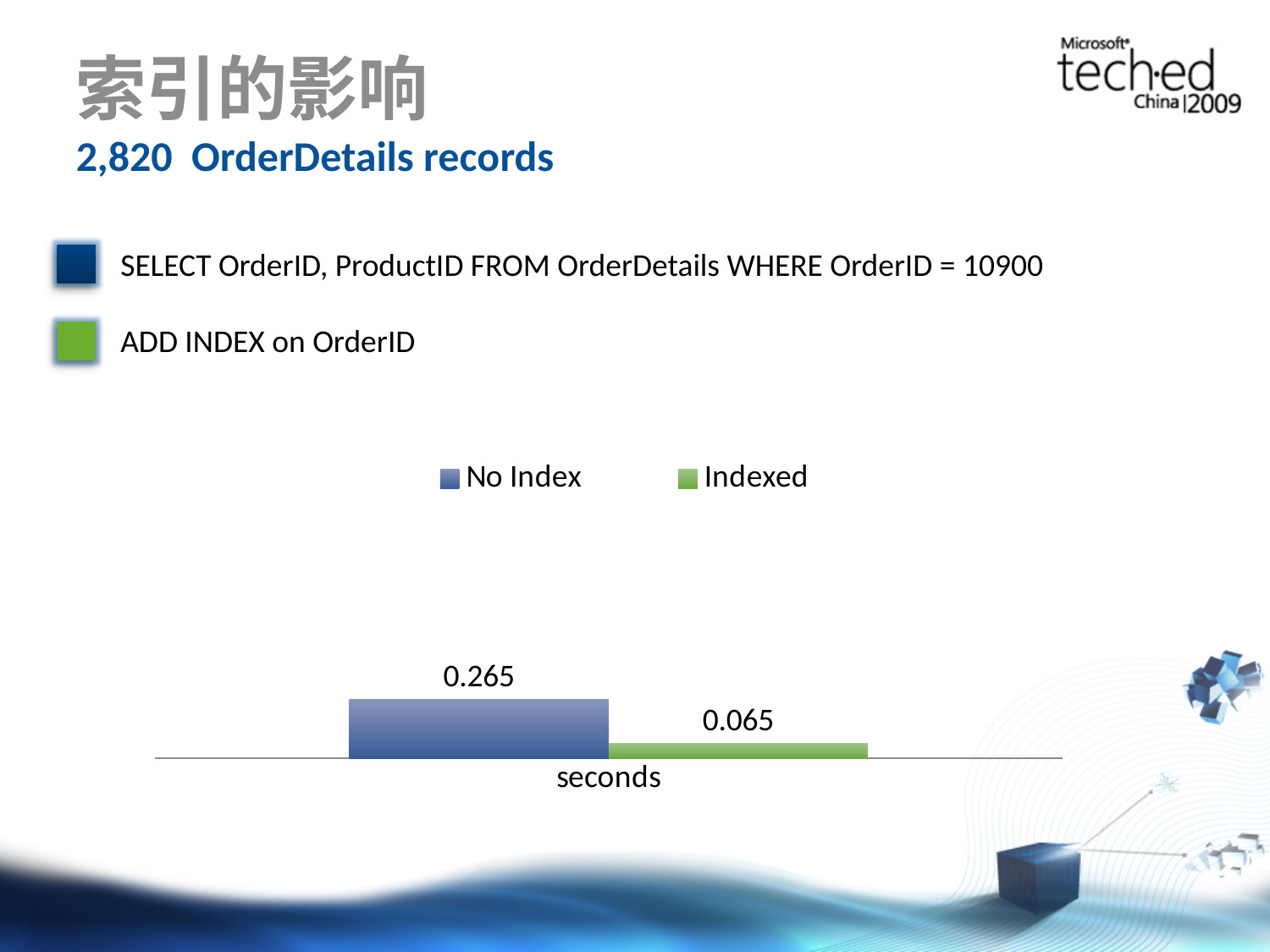
What is the value for Indexed in the chart? 0.065 Which series has the higher value, No Index or Indexed? No Index What is the category label shown under the bars? seconds What is the value for No Index in the chart? 0.265 What kind of chart is shown on the slide? bar chart What colour is the Indexed bar? green Which series has the lowest value in the chart? Indexed How many bars are plotted in the chart? 2 Which series has the highest value in the chart? No Index What is the difference between the No Index and Indexed values? 0.200 How many series does the legend list? 2